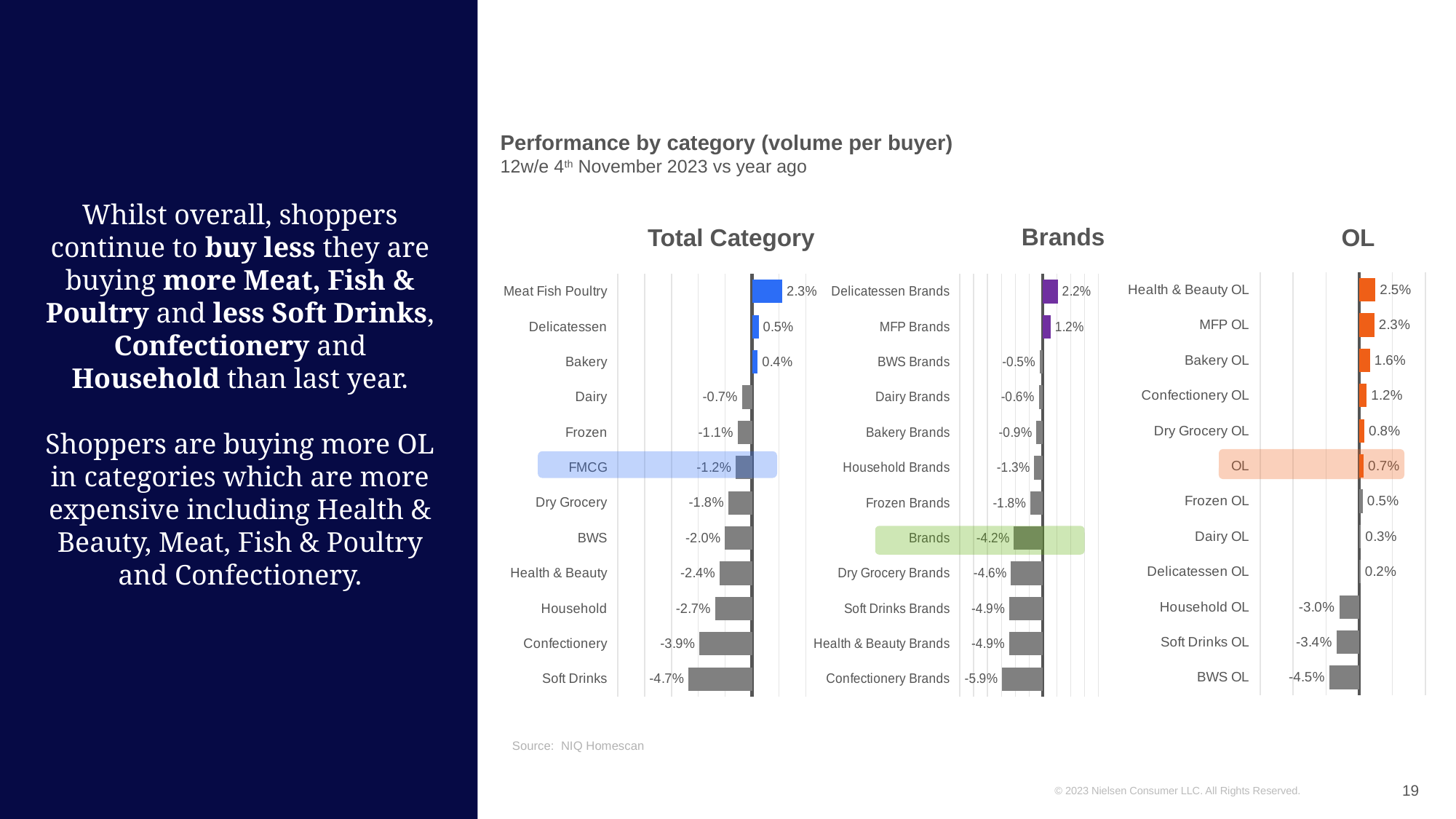
In the Brands chart, what is the value for Confectionery Brands? -5.9% What is the title of the overall chart section on the slide? Performance by category (volume per buyer) In the Total Category chart, what is the difference between the values for Meat Fish Poultry and Soft Drinks? 7.0% In the Brands chart, which category has the highest value? Delicatessen Brands In the Brands chart, which is larger, the value for MFP Brands or the value for Household Brands? MFP Brands What kind of chart is the Total Category chart? Bar chart In the Total Category chart, what is the value for FMCG? -1.2% In the Total Category chart, what is the value for Meat Fish Poultry? 2.3% How many categories are shown in the OL chart? 12 In the OL chart, which category has the lowest value? BWS OL In the OL chart, what is the value for Health & Beauty OL? 2.5% In the Total Category chart, which category has the lowest value? Soft Drinks